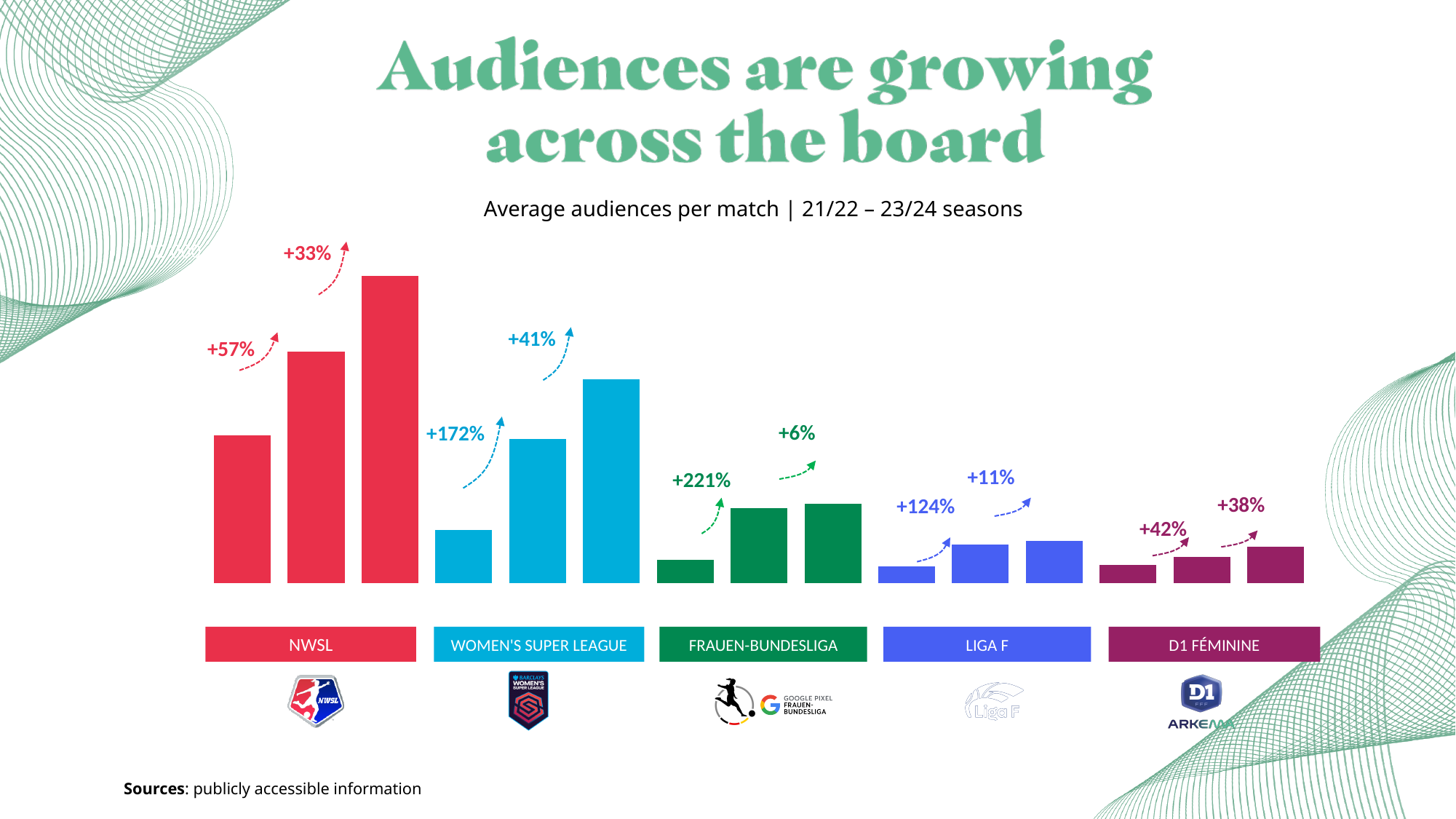
What kind of chart is shown on the slide? bar chart Which league has the shortest bars on the chart? D1 Féminine How many leagues are shown along the x axis of the chart? 5 Which league has the tallest bar on the chart? NWSL What is the second growth percentage printed for D1 Féminine? +38% Do the bars for each league rise or fall from left to right across the seasons? rise What is the second growth percentage printed for Liga F? +11% What is the first growth percentage printed for Frauen-Bundesliga? +221% What is the first growth percentage printed for Women's Super League? +172% What is the growth percentage printed above the first arrow for NWSL? +57% What is the growth percentage printed above the second arrow for NWSL? +33% How many bars are plotted in total on the chart? 15